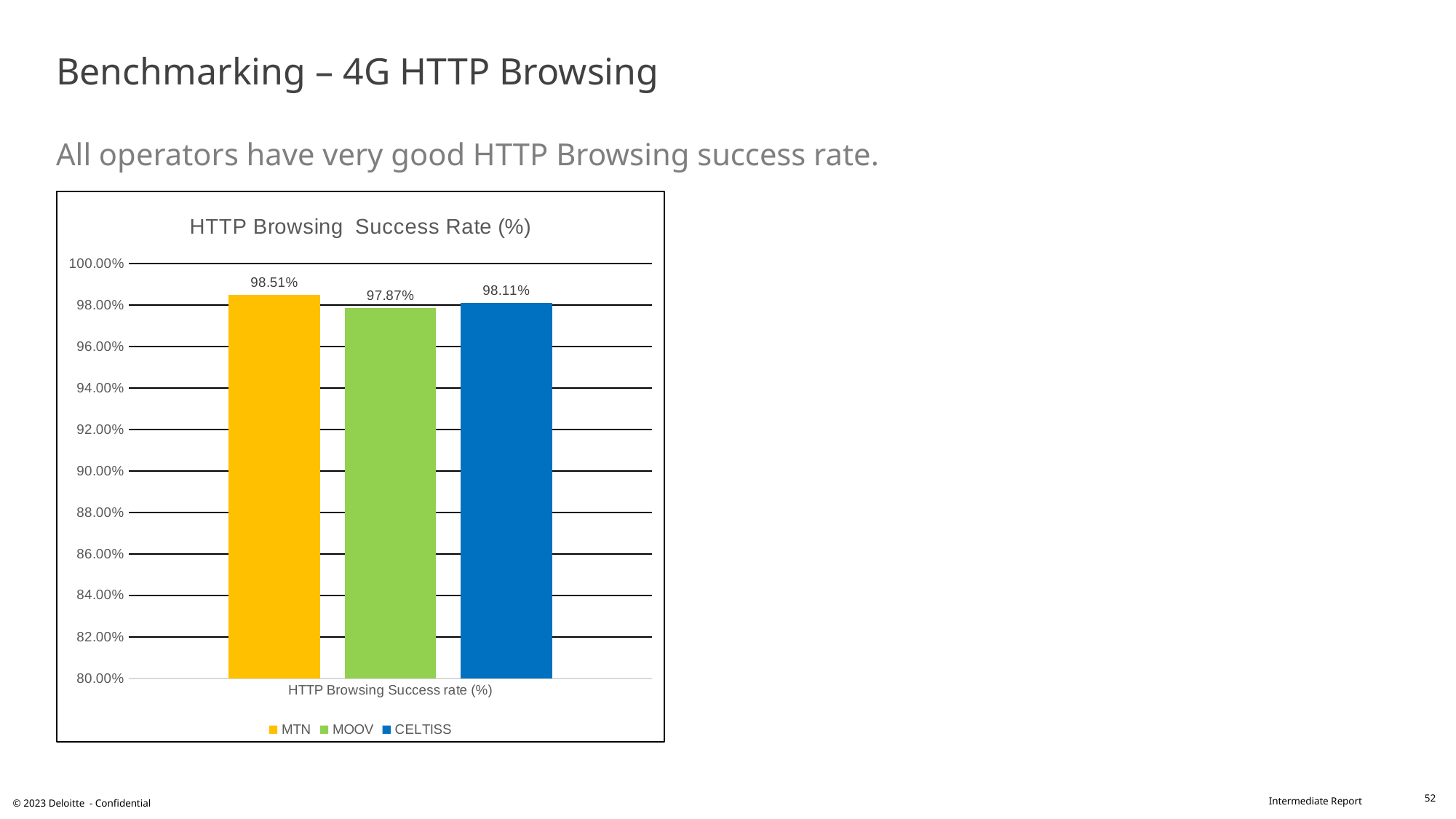
What is the HTTP Browsing success rate for MOOV? 97.87% Which operator has the lowest HTTP Browsing success rate? MOOV How many series does the legend list? 3 What is the difference between MTN's and MOOV's HTTP Browsing success rates? 0.64% Which has a higher HTTP Browsing success rate, MTN or CELTISS? MTN What is the HTTP Browsing success rate for CELTISS? 98.11% What is the HTTP Browsing success rate for MTN? 98.51% What is the title of the chart? HTTP Browsing Success Rate (%) What kind of chart is shown on the slide? Bar chart Which operator has the highest HTTP Browsing success rate? MTN What is the difference between CELTISS's and MOOV's HTTP Browsing success rates? 0.24% Is the HTTP Browsing success rate for MOOV greater or less than 98.00%? less